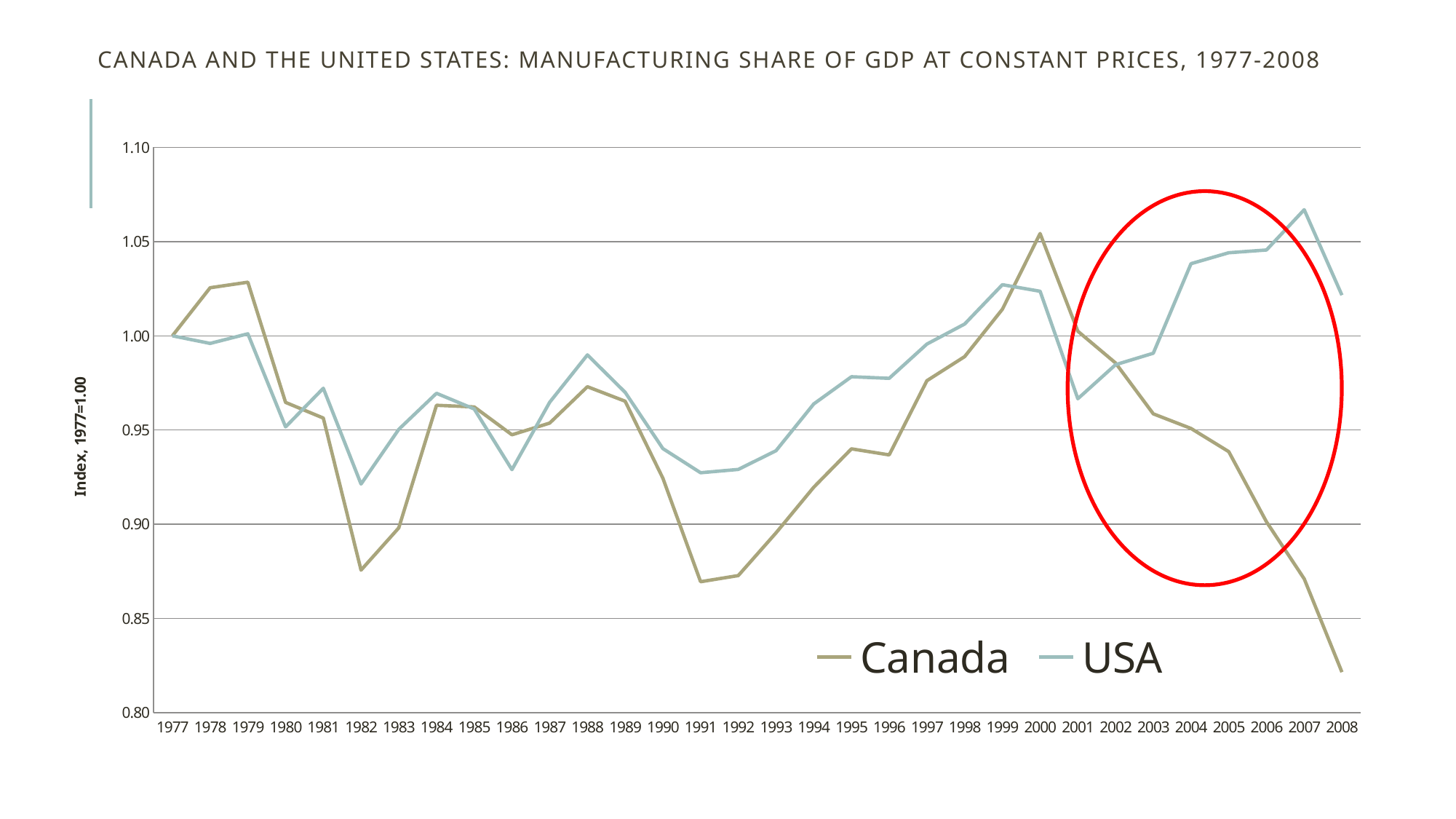
In which year does the USA line reach its highest value? 2007 In which year does the Canada line reach its lowest value? 2008 How many series does the legend list? 2 Which series has the larger value in 2008, Canada or USA? USA Does the Canada line rise or fall from 2000 to 2008? fall How many years are plotted along the x axis? 32 Is the value for USA in 2007 greater or less than 1.05? greater Is the value for Canada in 1982 greater or less than 0.90? less Is the value for Canada in 2008 greater or less than 0.85? less What kind of chart is shown on the slide? line chart In which year does the Canada line reach its highest value? 2000 What is the index value for Canada in 1977? 1.00